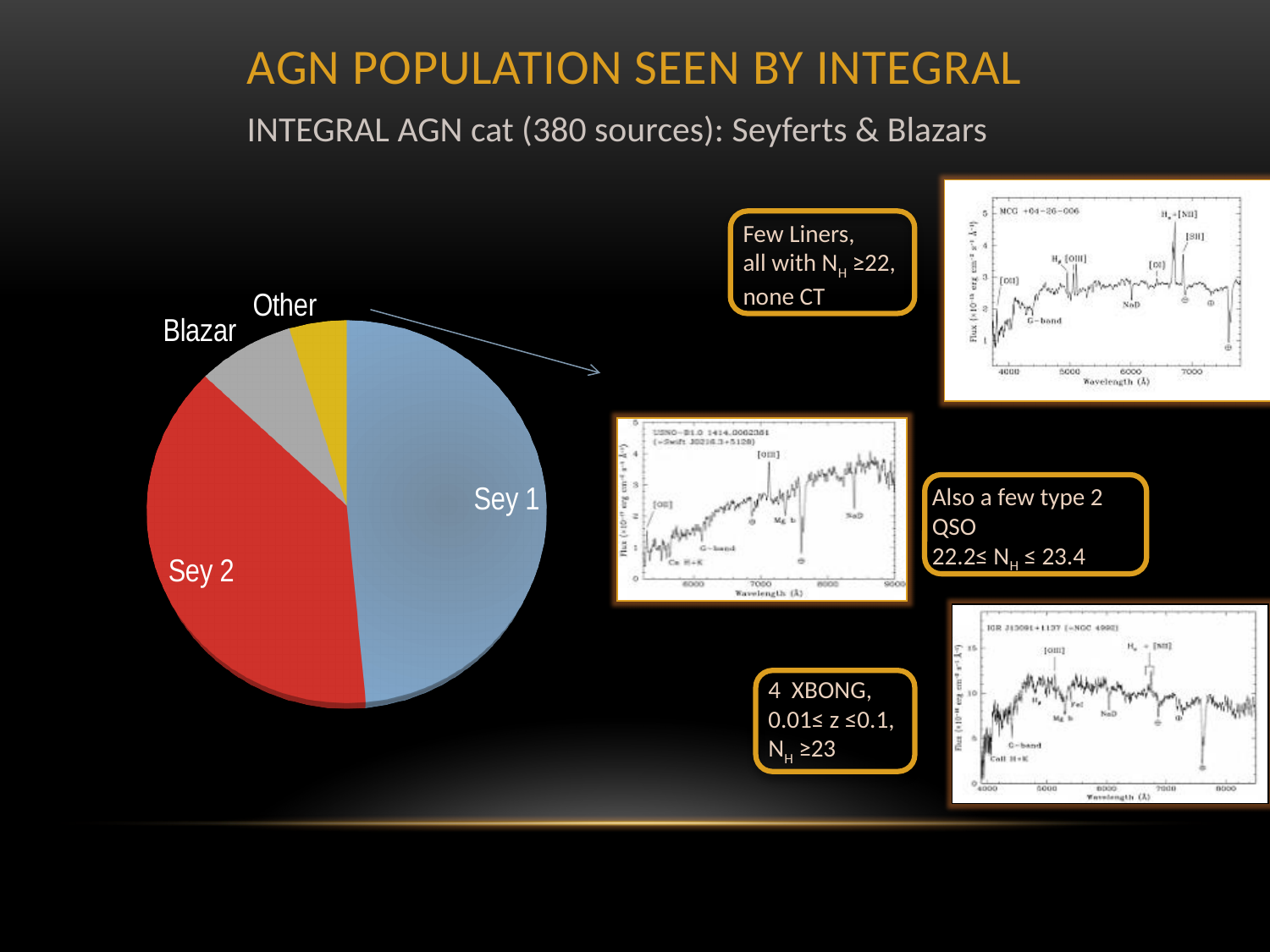
Which category has the largest slice in the pie chart? Sey 1 In the pie chart, which slice is larger, Sey 1 or Sey 2? Sey 1 Which two categories in the pie chart together make up the large majority of the pie? Sey 1 and Sey 2 What colour is the Sey 2 slice in the pie chart? red What kind of chart is shown on the left of the slide? pie chart In the pie chart, which slice is larger, Sey 2 or Blazar? Sey 2 Which category has the smallest slice in the pie chart? Other Which category in the pie chart is shown in yellow? Other How many slices does the pie chart have? 4